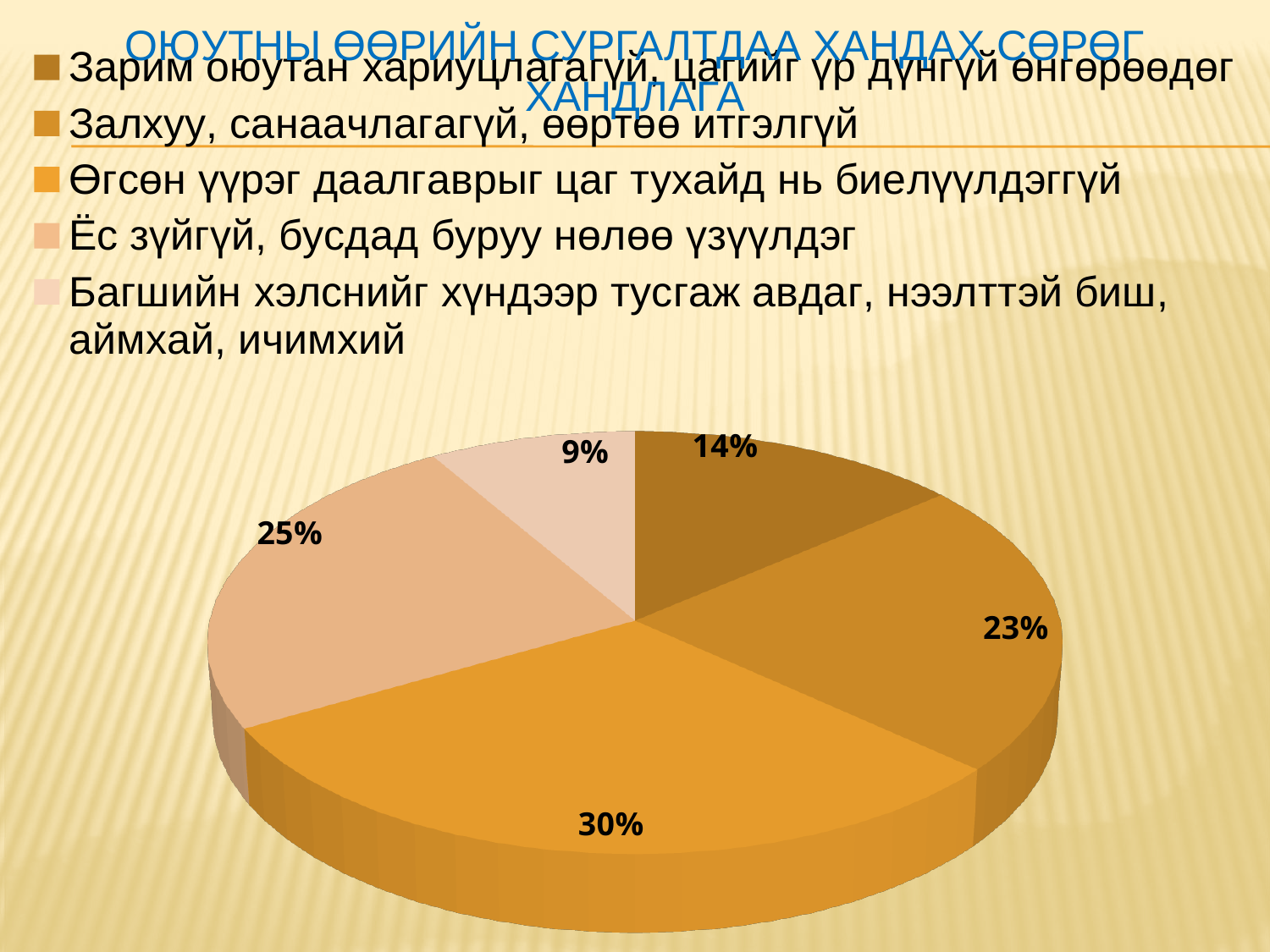
What is the difference in percentage points between the 30% slice and the 9% slice? 21 What percentage is shown for the slice 'Залхуу, санаачлагагүй, өөртөө итгэлгүй'? 23% How many slices does the pie chart have? 5 What percentage is shown for the slice 'Өгсөн үүрэг даалгаврыг цаг тухайд нь биелүүлдэггүй'? 30% Which is larger: the share for 'Залхуу, санаачлагагүй, өөртөө итгэлгүй' or the share for 'Ёс зүйгүй, бусдад буруу нөлөө үзүүлдэг'? Ёс зүйгүй, бусдад буруу нөлөө үзүүлдэг Which slice has the largest share of the pie? Өгсөн үүрэг даалгаврыг цаг тухайд нь биелүүлдэггүй What percentage is shown for the slice 'Зарим оюутан хариуцлагагүй, цагийг үр дүнгүй өнгөрөөдөг'? 14% Which slice has the smallest share of the pie? Багшийн хэлснийг хүндээр тусгаж авдаг, нээлттэй биш, аймхай, ичимхий What percentage is shown for the slice 'Ёс зүйгүй, бусдад буруу нөлөө үзүүлдэг'? 25% What kind of chart is shown on the slide? Pie chart What is the title of the chart? ОЮУТНЫ ӨӨРИЙН СУРГАЛТДАА ХАНДАХ СӨРӨГ ХАНДЛАГА How many entries does the legend list? 5